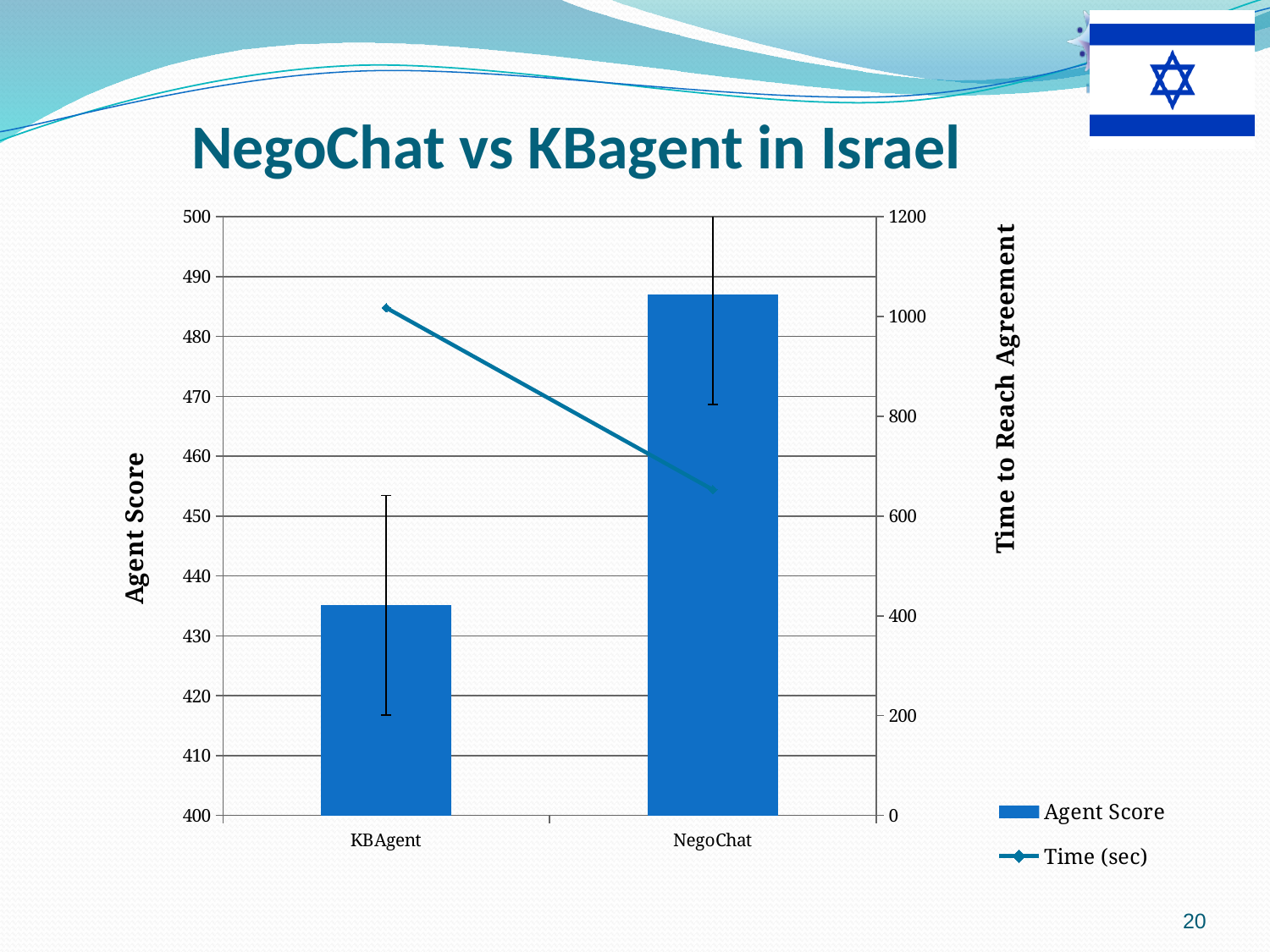
How many series does the legend list? 2 Which category has the higher Agent Score? NegoChat Is the Agent Score for NegoChat greater or less than 480? greater Which category has the higher Time (sec) value, KBAgent or NegoChat? KBAgent Is the Agent Score for KBAgent greater or less than 440? less What is the label of the right-hand vertical axis? Time to Reach Agreement Is the Time (sec) value for NegoChat greater or less than 800? less How many categories are shown on the x axis? 2 Does the Time (sec) line rise or fall from KBAgent to NegoChat? fall What is the title of the slide's chart? NegoChat vs KBagent in Israel Which category has the lower Agent Score? KBAgent